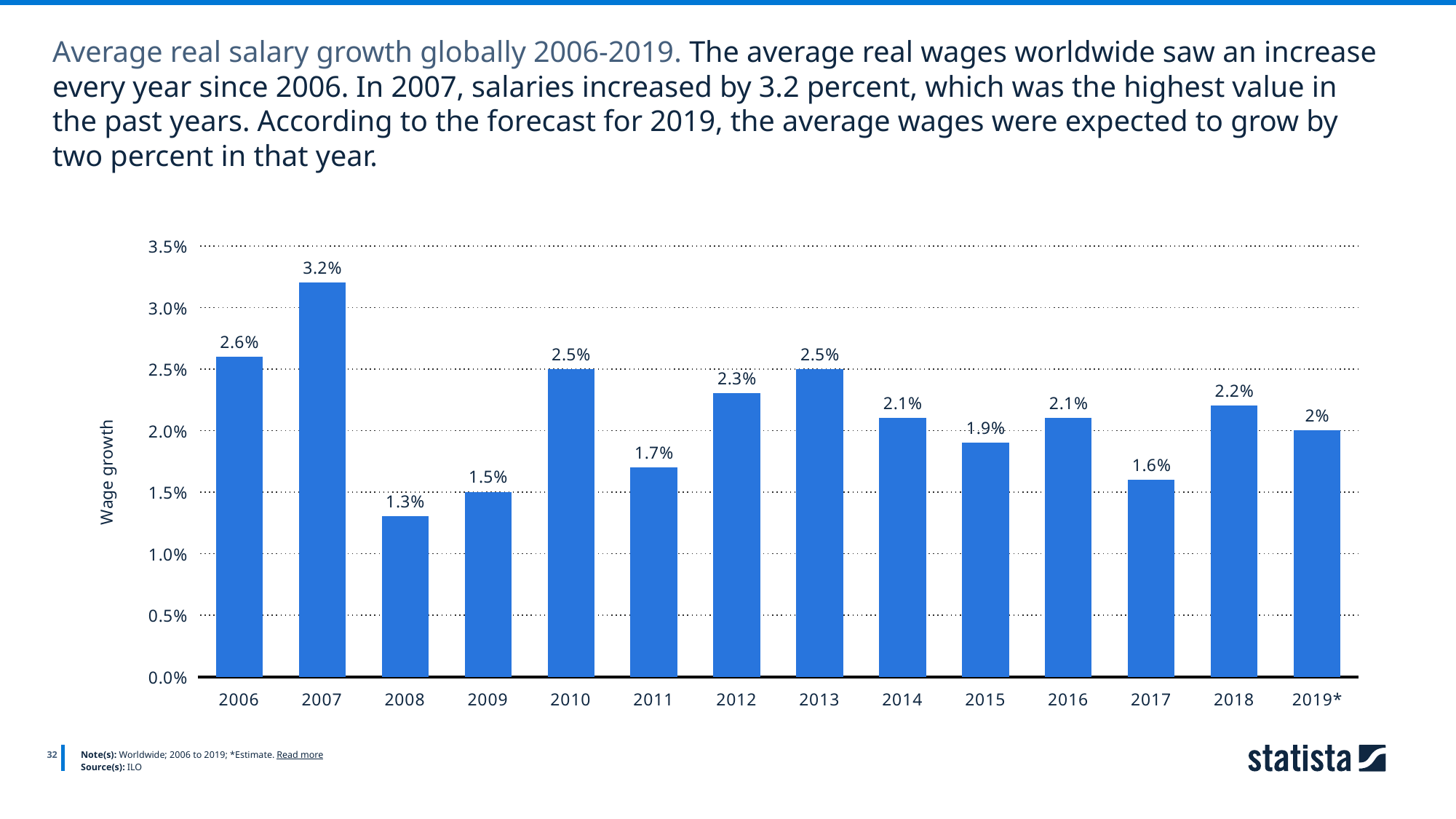
What is the label of the y axis? Wage growth What was the wage growth in 2008? 1.3% What was the wage growth in 2007? 3.2% What is the difference between the wage growth in 2006 and in 2017? 1.0% What is the difference between the wage growth in 2007 and in 2008? 1.9% What kind of chart is shown on the slide? Bar chart Which year had higher wage growth, 2012 or 2015? 2012 How many years are shown on the x axis? 14 What is the wage growth value shown for 2019*? 2% Which year has the lowest wage growth? 2008 Is the wage growth for 2011 greater or less than 2.0%? less Which year has the highest wage growth? 2007